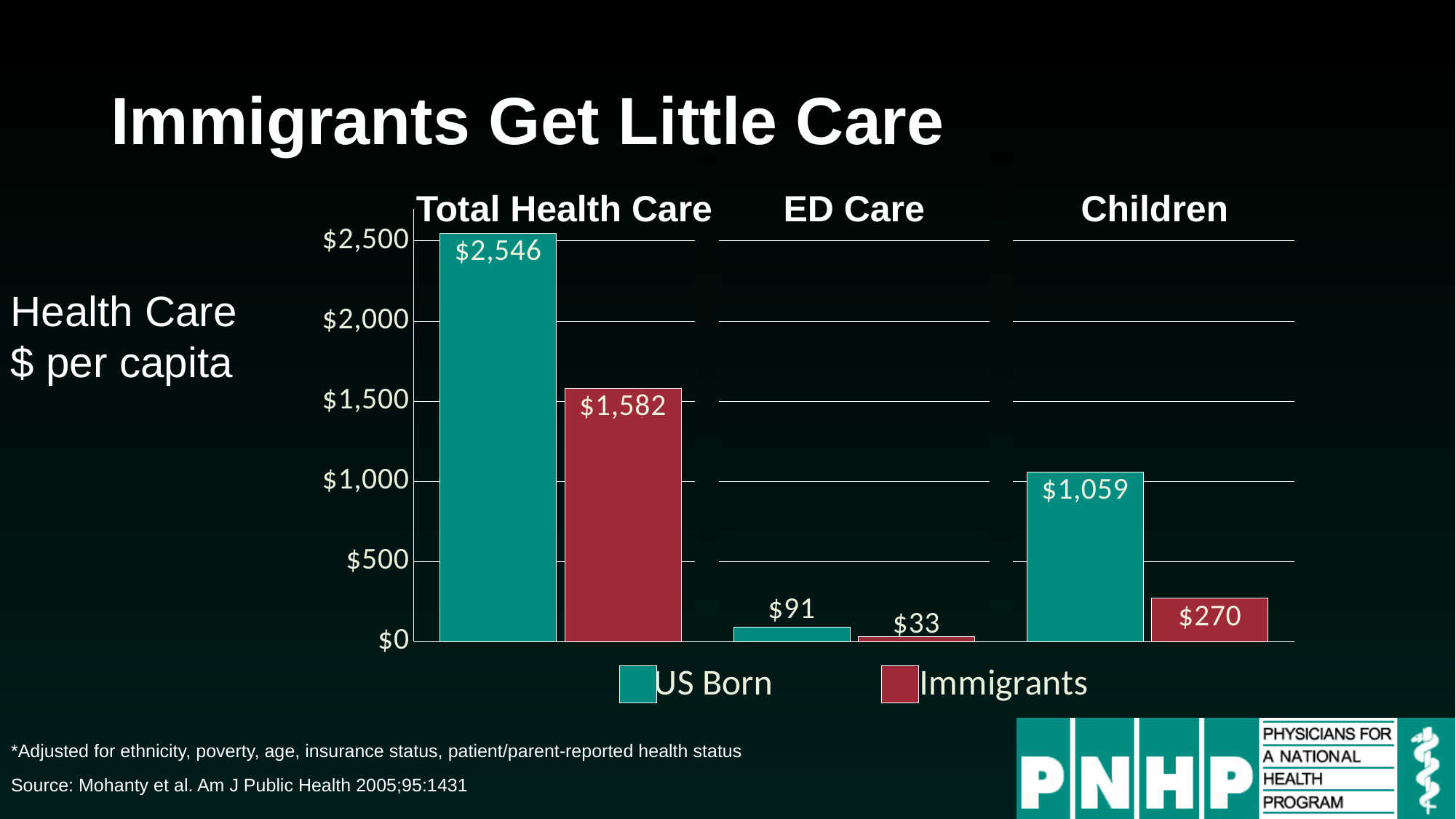
What kind of chart is shown on the slide? Bar chart How many categories are shown on the x axis? 3 What is the ED Care value for Immigrants? $33 How many series does the legend list? 2 What is the difference between the US Born and Immigrants values for Total Health Care? $964 What is the Total Health Care value for Immigrants? $1,582 Which is larger for ED Care, the US Born value or the Immigrants value? US Born What is the difference between the US Born and Immigrants values for Children? $789 What is the Total Health Care value for US Born? $2,546 Which category has the highest value for US Born? Total Health Care Which category has the lowest value for Immigrants? ED Care What is the Children value for US Born? $1,059